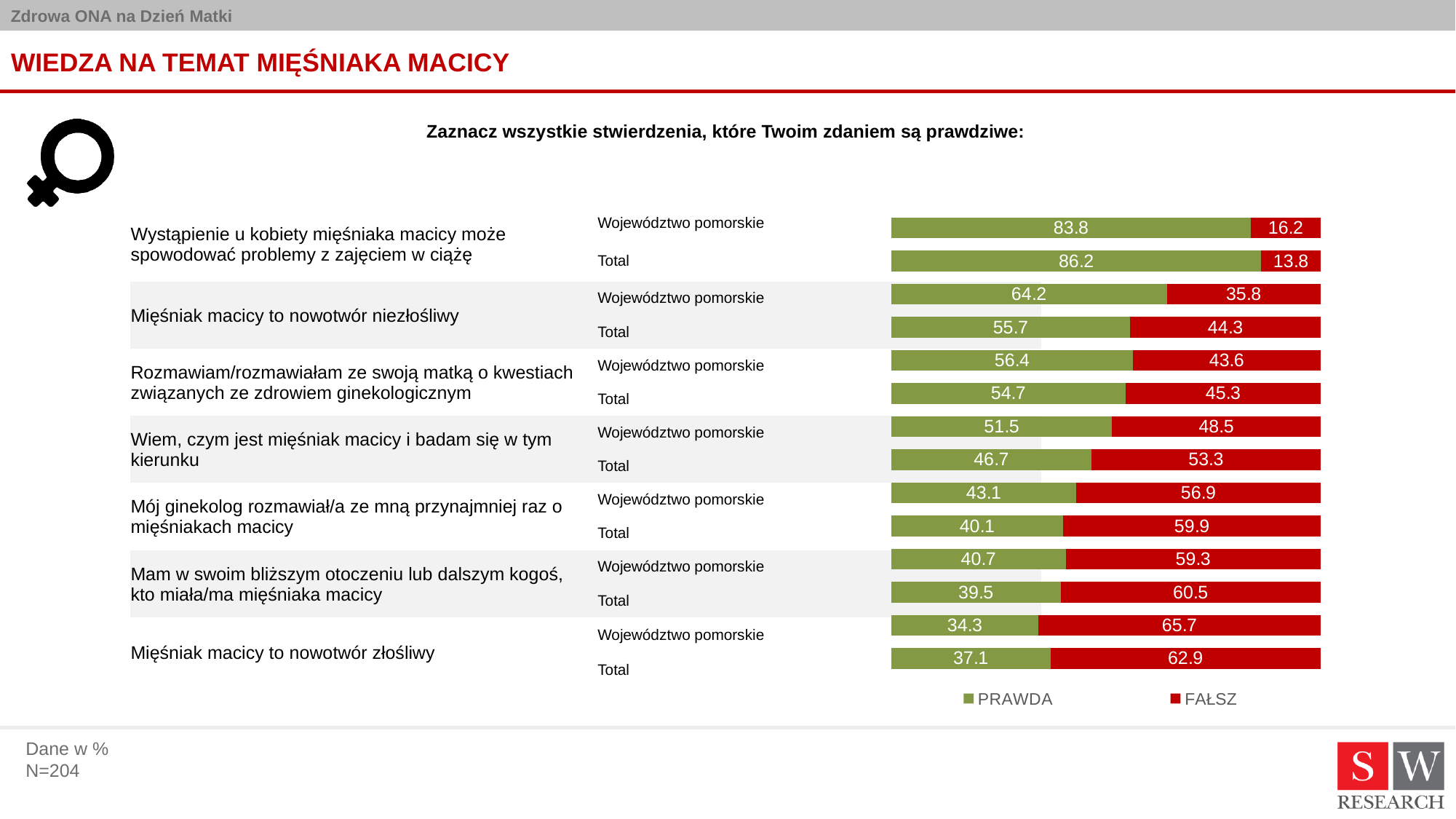
What is the difference between the PRAWDA values for Województwo pomorskie and Total for the statement "Mięśniak macicy to nowotwór niezłośliwy"? 8.5 For the statement "Wiem, czym jest mięśniak macicy i badam się w tym kierunku", which is larger: the PRAWDA value for Województwo pomorskie or for Total? Województwo pomorskie How many statements are shown in the chart? 7 What is the PRAWDA value for Total for the statement "Mięśniak macicy to nowotwór złośliwy"? 37.1 How many series does the legend list? 2 What is the PRAWDA value for Województwo pomorskie for the statement "Wystąpienie u kobiety mięśniaka macicy może spowodować problemy z zajęciem w ciążę"? 83.8 Which colour represents FAŁSZ in the chart? Red What type of chart is shown on the slide? Stacked bar chart Which statement has the lowest PRAWDA value for Województwo pomorskie? Mięśniak macicy to nowotwór złośliwy What is the total of the stacked bar for Total for the statement "Mój ginekolog rozmawiał/a ze mną przynajmniej raz o mięśniakach macicy"? 100 Which statement has the highest PRAWDA value for Total? Wystąpienie u kobiety mięśniaka macicy może spowodować problemy z zajęciem w ciążę What is the FAŁSZ value for Total for the statement "Mięśniak macicy to nowotwór niezłośliwy"? 44.3